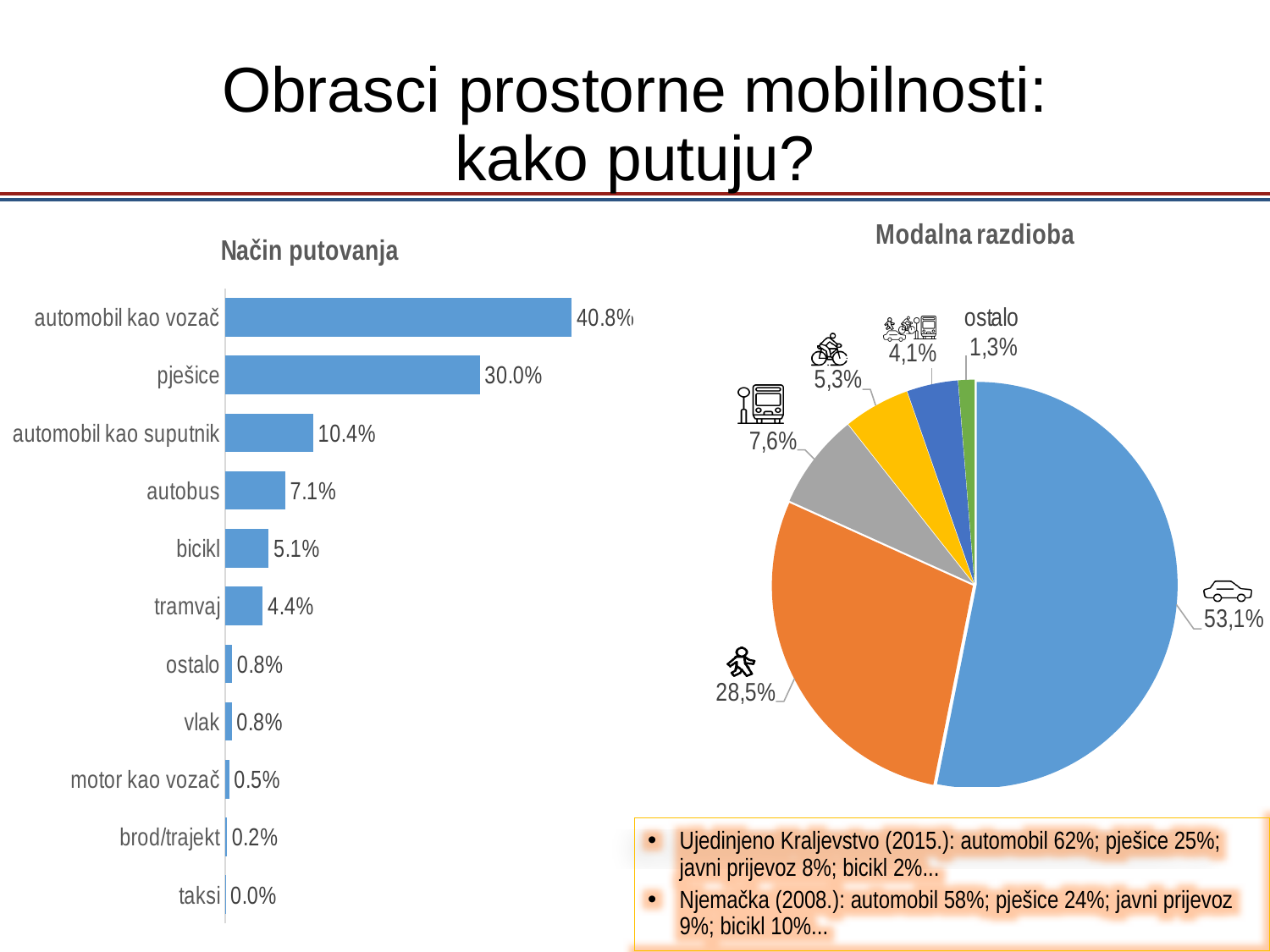
How many categories are shown in the 'Način putovanja' bar chart? 11 In the 'Način putovanja' bar chart, what is the difference between 'automobil kao vozač' and 'pješice'? 10.8% In the 'Način putovanja' bar chart, what is the value for 'tramvaj'? 4.4% In the 'Način putovanja' bar chart, which category has the highest value? automobil kao vozač In the 'Način putovanja' bar chart, what is the value for 'automobil kao vozač'? 40.8% In the 'Modalna razdioba' pie chart, what share does the 'ostalo' slice have? 1,3% In the 'Način putovanja' bar chart, which is larger: 'autobus' or 'bicikl'? autobus In the 'Način putovanja' bar chart, what is the value for 'pješice'? 30.0% How many slices does the 'Modalna razdioba' pie chart have? 6 What type of chart is 'Način putovanja'? bar chart In the 'Način putovanja' bar chart, which category has the lowest value? taksi In the 'Modalna razdioba' pie chart, what is the value of the largest slice? 53,1%